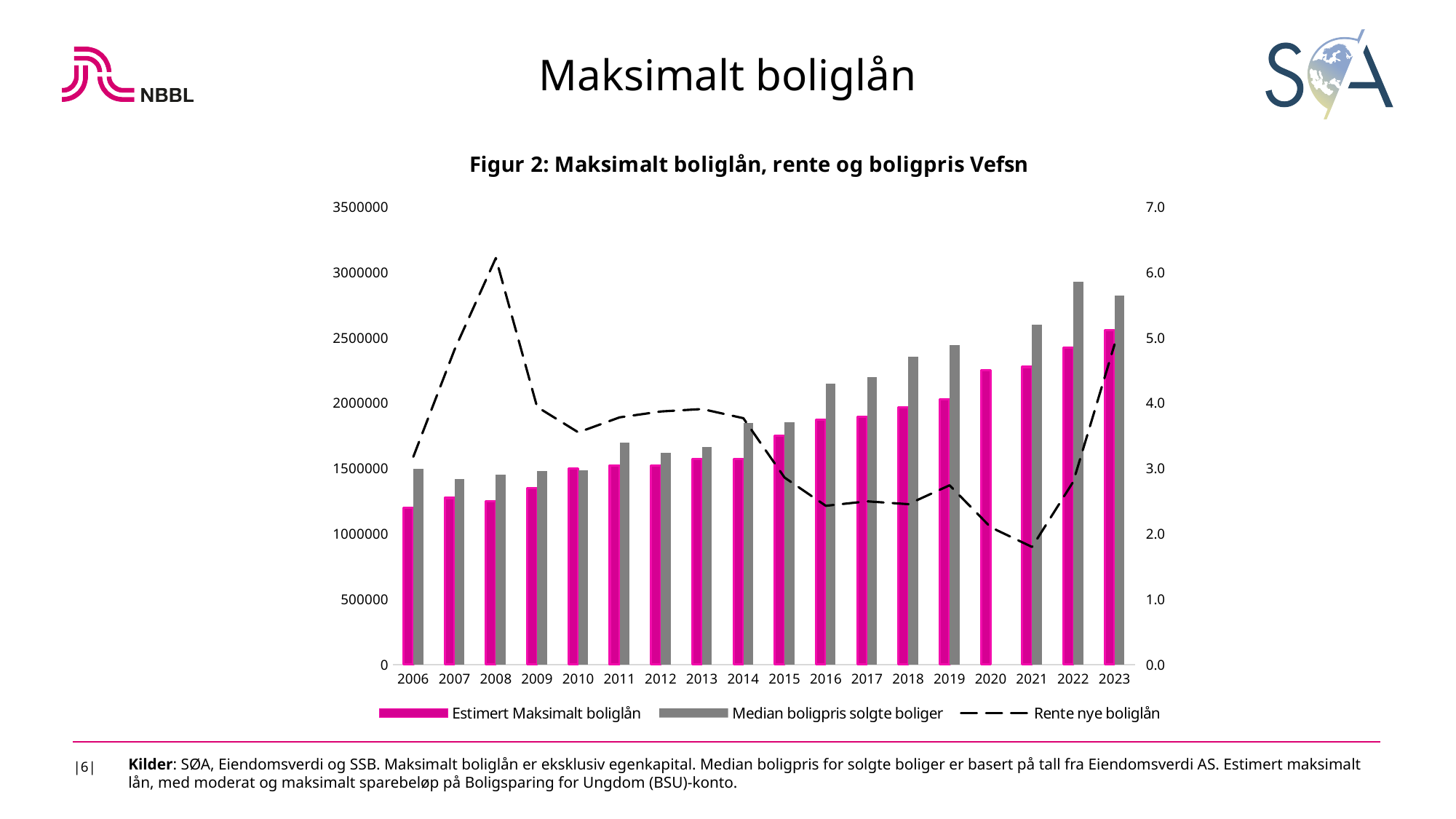
Does Estimert Maksimalt boliglån generally rise or fall from 2006 to 2023? rise In which year is Rente nye boliglån lowest? 2021 What kind of chart is shown on the slide? bar chart with a line Is the value for Median boligpris solgte boliger in 2022 greater or less than 2500000? greater In 2023, which is larger: Estimert Maksimalt boliglån or Median boligpris solgte boliger? Median boligpris solgte boliger How many series does the legend list? 3 Is the value for Rente nye boliglån in 2021 greater or less than 2.0? less In which year does Rente nye boliglån reach its highest value? 2008 Is the value for Estimert Maksimalt boliglån in 2006 greater or less than 1500000? less In which year is Estimert Maksimalt boliglån lowest? 2006 How many years are shown on the x axis? 18 In which year is Median boligpris solgte boliger highest? 2022